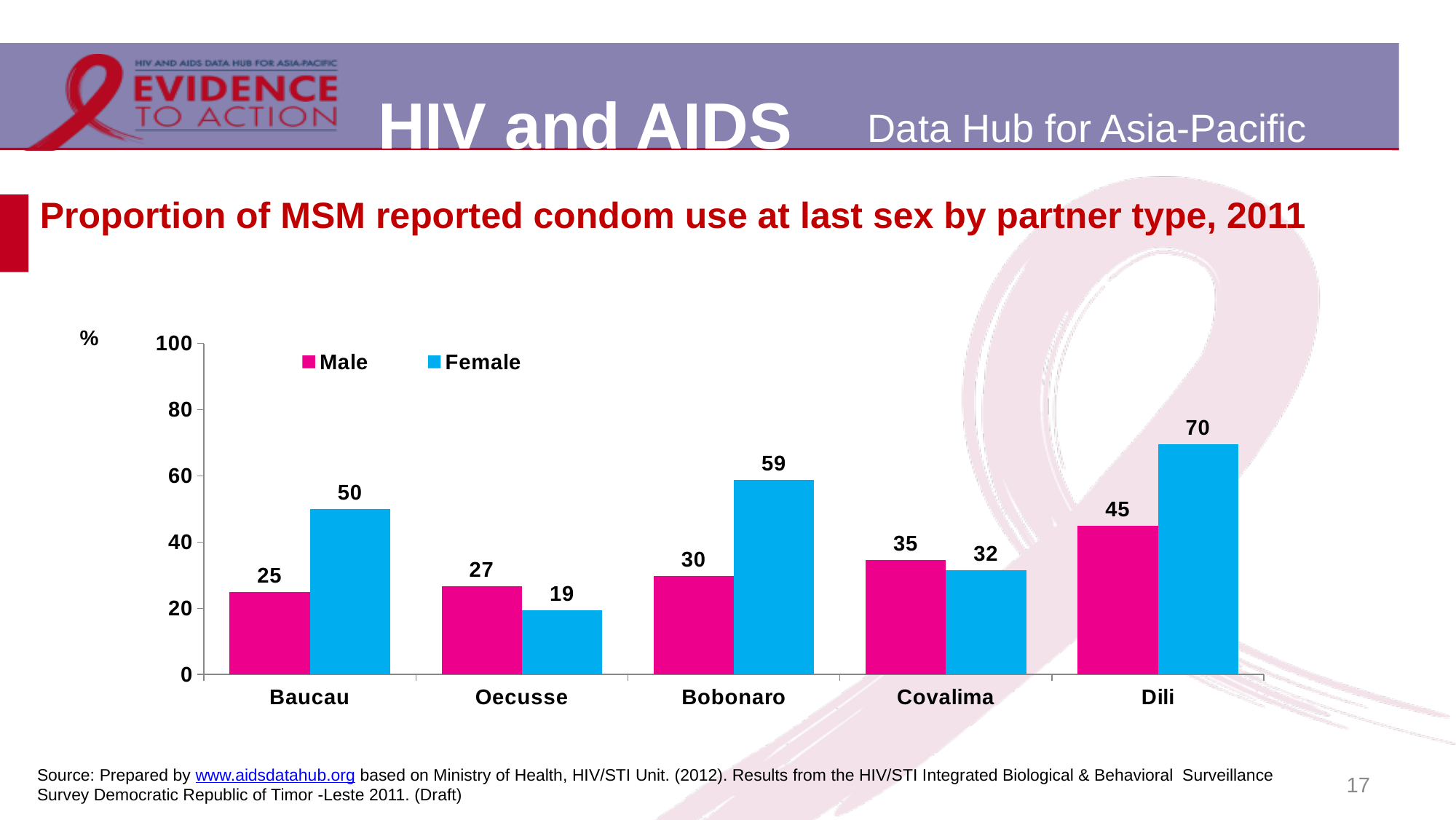
Is the Female value for Baucau greater or less than 40? greater How many districts are shown on the x axis? 5 What is the difference between the Female and Male values in Bobonaro? 29 What is the value for Female in Dili? 70 What is the value for Male in Oecusse? 27 Which is larger in Covalima, the Male value or the Female value? Male How many series does the legend list? 2 Which district has the highest Male value? Dili Which district has the lowest Female value? Oecusse What is the value for Female in Bobonaro? 59 What kind of chart is shown on the slide? Bar chart What colour are the Male bars? Pink